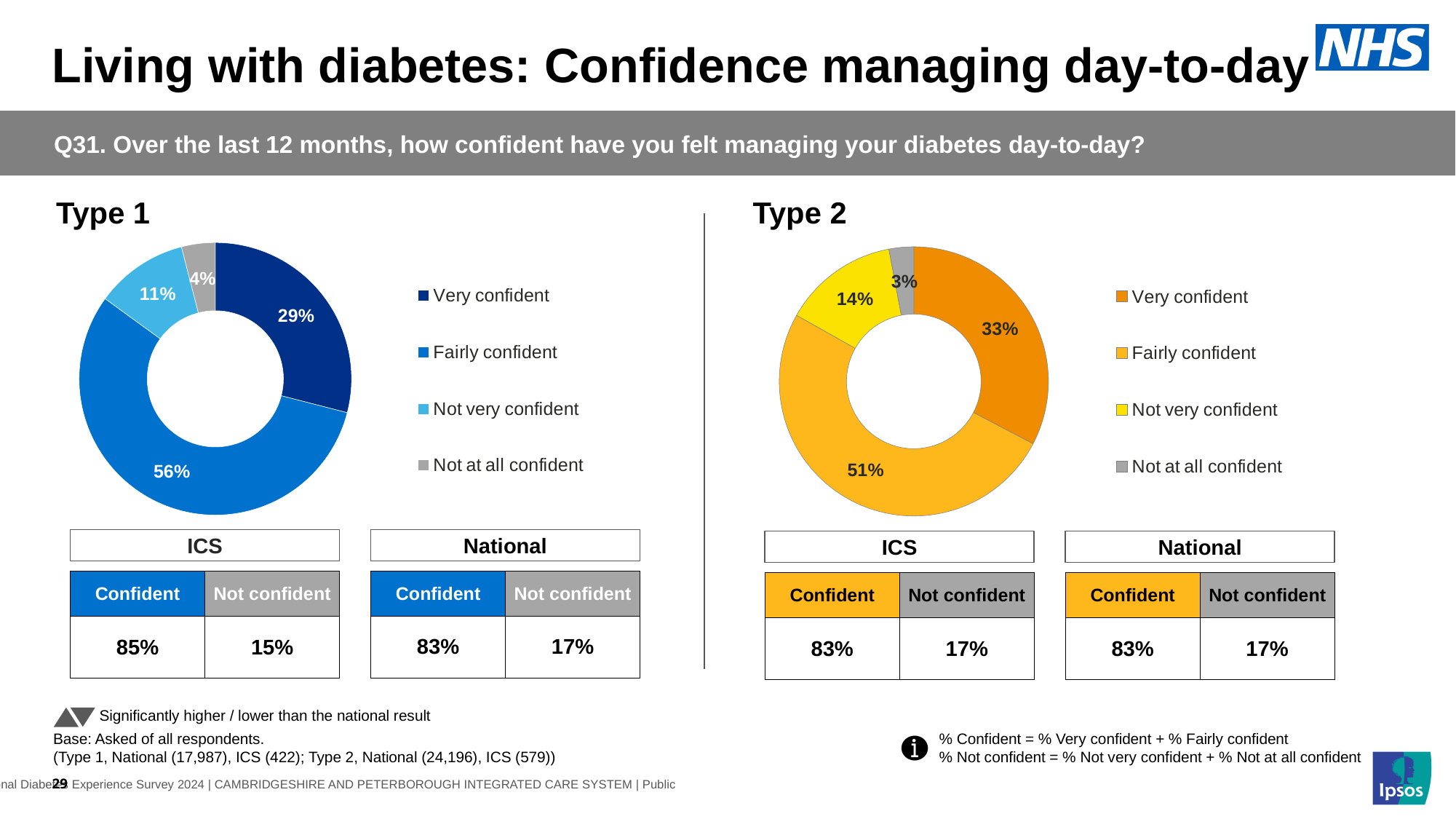
In the Type 1 chart, what percentage of respondents were Very confident? 29% In the Type 2 chart, what is the combined share of Not very confident and Not at all confident? 17% How many categories does the Type 2 chart's legend list? 4 What kind of chart is used for Type 1? Doughnut (pie) chart In the Type 1 chart, what percentage of respondents were Not at all confident? 4% In the Type 2 chart, which category has the smallest share? Not at all confident In the Type 2 chart, what percentage of respondents were Not very confident? 14% In the Type 1 chart, what colour represents Not very confident? Light blue In the Type 2 chart, what percentage of respondents were Fairly confident? 51% In the Type 1 chart, what is the difference between the Fairly confident and Very confident shares? 27 percentage points In the Type 1 chart, which category has the largest share? Fairly confident Which is larger: the Very confident share in the Type 1 chart or the Very confident share in the Type 2 chart? Type 2